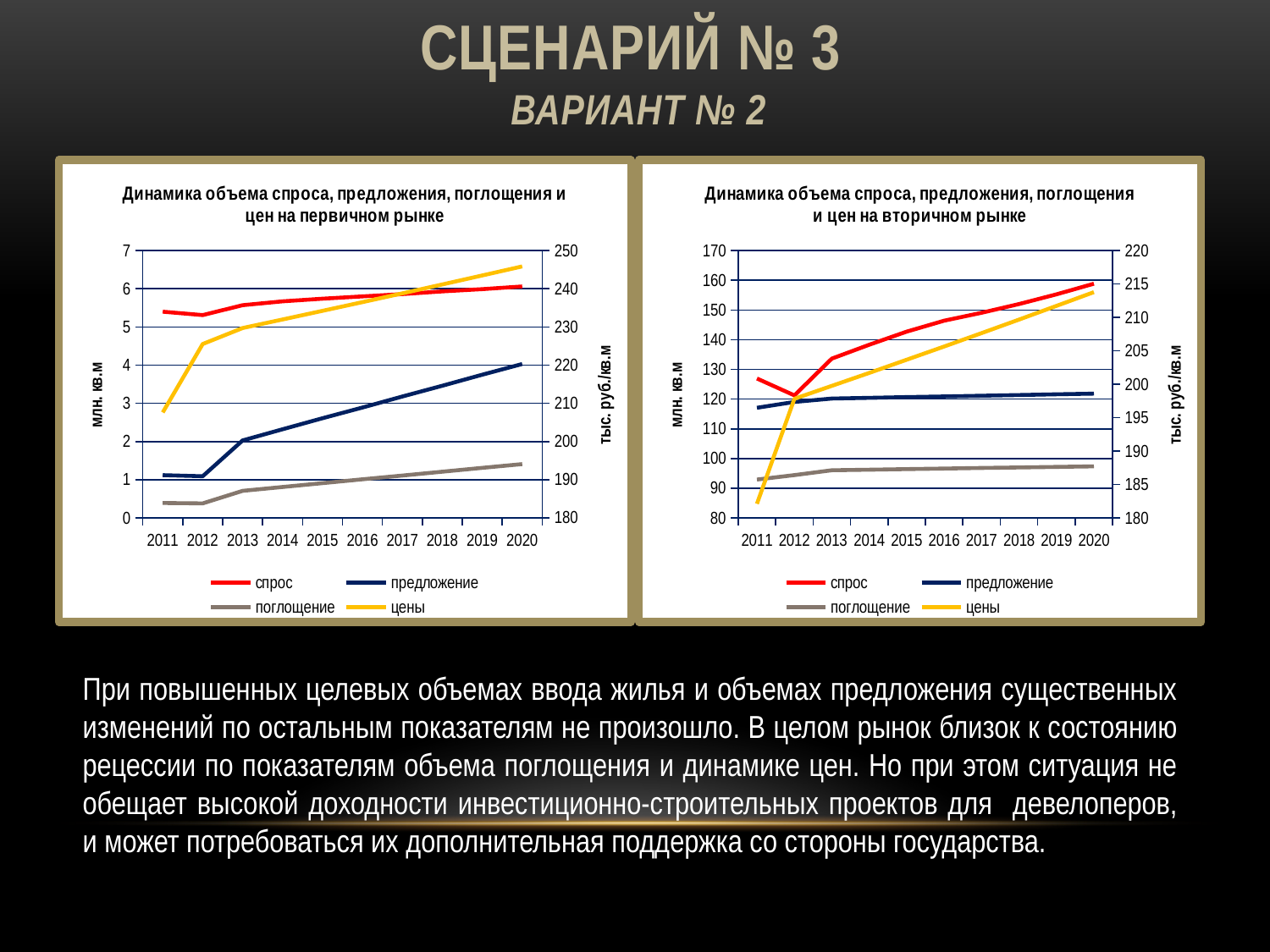
What is the label of the right-hand vertical axis on the left chart (первичный рынок)? тыс. руб./кв.м How many series does the legend of the right chart, 'Динамика объема спроса, предложения, поглощения и цен на вторичном рынке', list? 4 In the left chart (первичный рынок), which is larger in 2020: 'спрос' or 'предложение'? спрос What kind of chart is the left chart, 'Динамика объема спроса, предложения, поглощения и цен на первичном рынке'? line chart In the right chart (вторичный рынок), is the value for 'спрос' in 2020 greater or less than 150? greater In the left chart (первичный рынок), is the value for 'поглощение' in 2020 greater or less than 1? greater In the right chart (вторичный рынок), is the value for 'поглощение' in 2020 greater or less than 100? less In the right chart (вторичный рынок), which is larger in 2020: 'предложение' or 'поглощение'? предложение In the left chart (первичный рынок), does the 'предложение' series rise or fall from 2011 to 2020? rise How many years are shown on the x axis of the left chart (первичный рынок)? 10 In the right chart (вторичный рынок), does the 'цены' series rise or fall from 2011 to 2020? rise